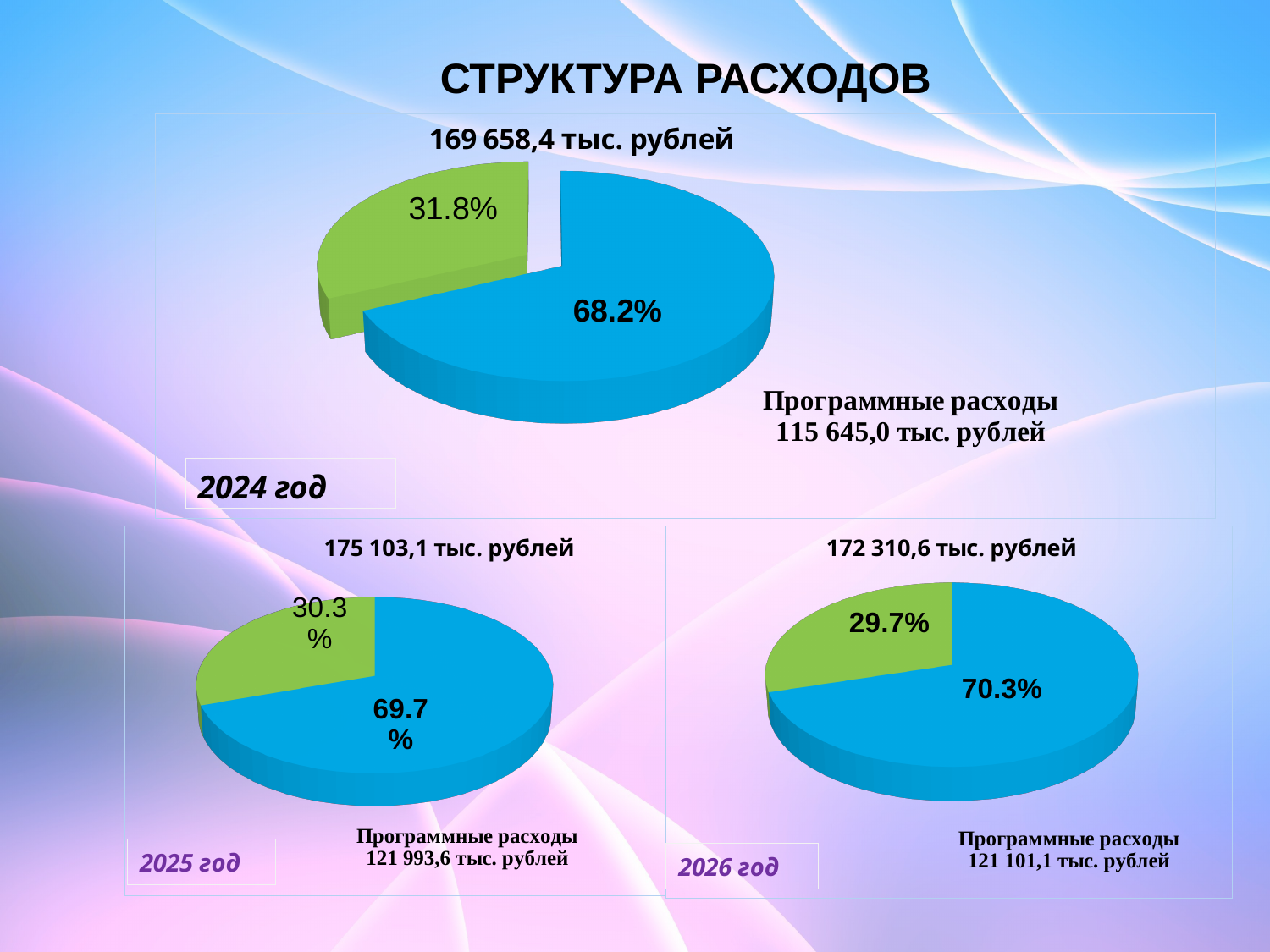
In the 2025 год pie chart, what share is labelled on the blue slice (Программные расходы)? 69.7% In the 2024 год pie chart, what is the difference in percentage points between the blue slice and the green slice? 36.4 What amount of Программные расходы is shown for the 2026 год pie chart? 121 101,1 тыс. рублей How many slices does the 2025 год pie chart have? 2 What kind of chart is used for the 2024 год chart? pie chart In the 2024 год pie chart, what share is labelled on the green slice? 31.8% In the 2026 год pie chart, which slice is larger, the blue one or the green one? the blue one What amount of Программные расходы is shown for the 2024 год pie chart? 115 645,0 тыс. рублей What total amount is shown above the 2025 год pie chart? 175 103,1 тыс. рублей In the 2026 год pie chart, what share is labelled on the green slice? 29.7% What is the title of the slide containing the three pie charts? СТРУКТУРА РАСХОДОВ